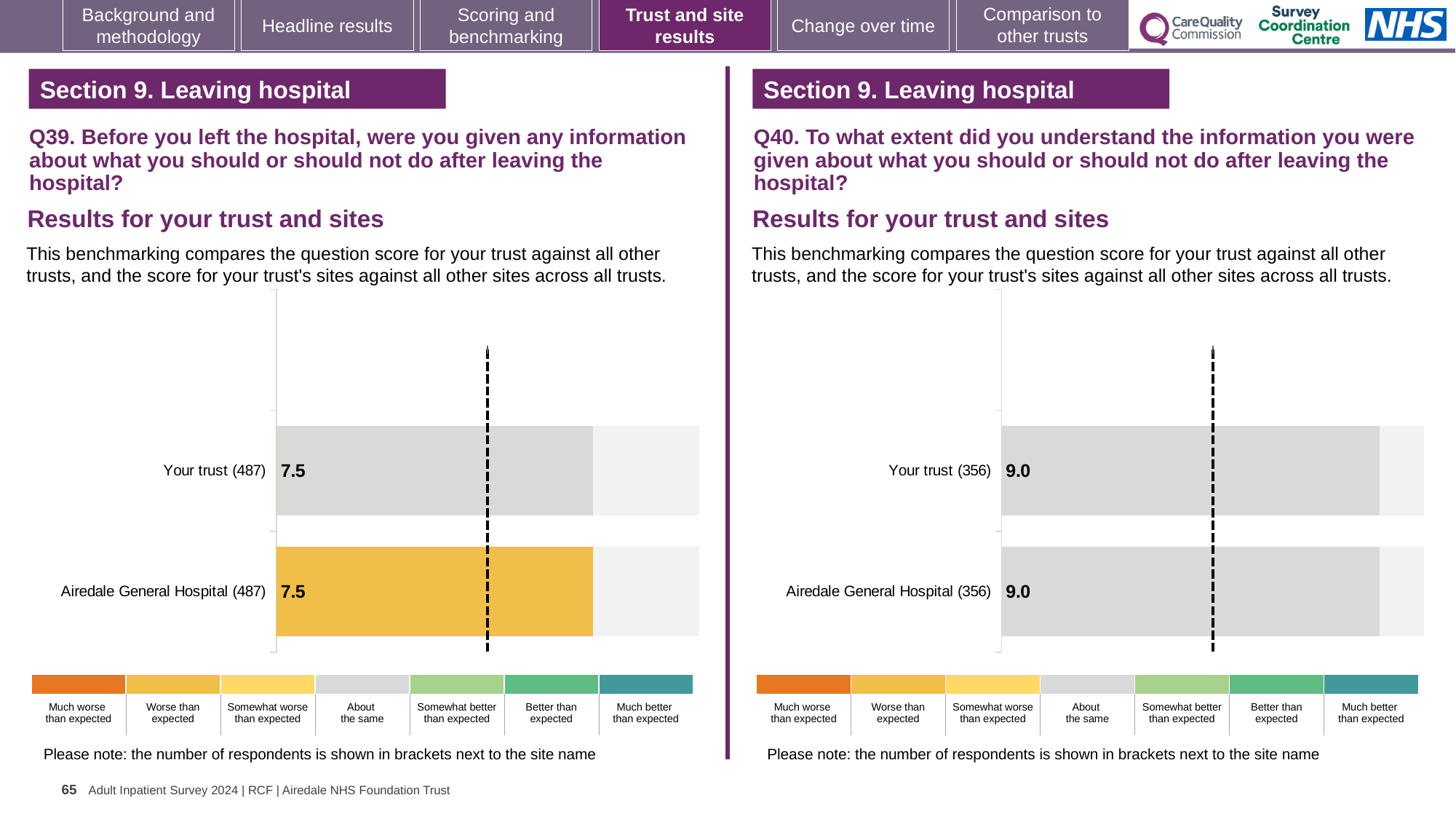
In the right chart (Q40), what is the score for Your trust? 9.0 In the right chart (Q40), how many respondents are shown in brackets next to Your trust? 356 In the left chart (Q39), what is the score for Airedale General Hospital? 7.5 In the left chart (Q39), what is the score for Your trust? 7.5 In the left chart (Q39), what is the difference between the score for Your trust and the score for Airedale General Hospital? 0.0 How many bars are plotted in the left chart (Q39)? 2 In the right chart (Q40), what is the score for Airedale General Hospital? 9.0 In the right chart (Q40), what is the difference between the score for Your trust and the score for Airedale General Hospital? 0.0 In the left chart (Q39), how many respondents are shown in brackets next to Airedale General Hospital? 487 What kind of chart is used in the left chart (Q39)? Bar chart How many bars are plotted in the right chart (Q40)? 2 In the left chart (Q39), what colour is the bar for Airedale General Hospital? Yellow/orange